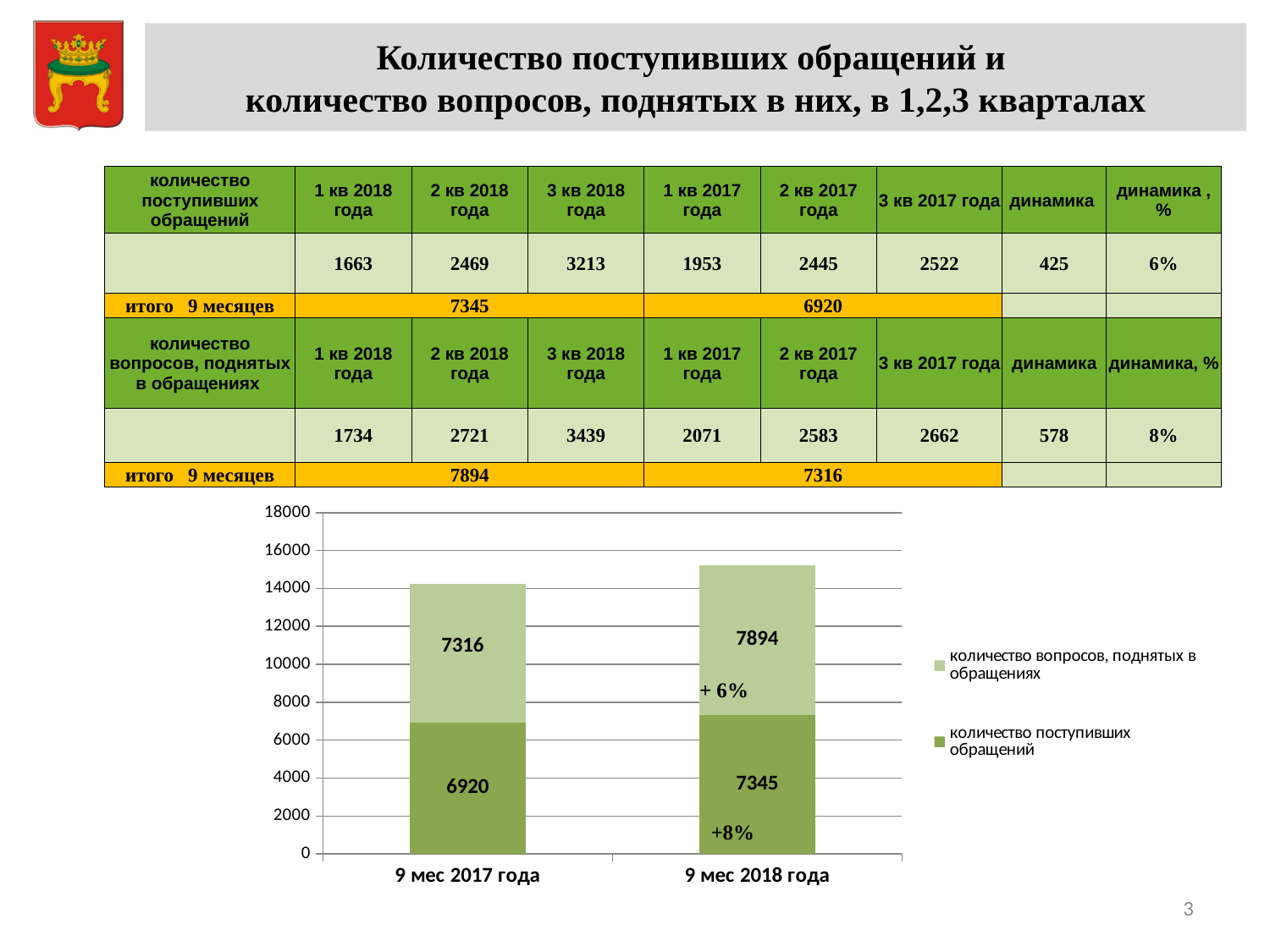
Which colour represents "количество поступивших обращений" in the chart? dark green How many series does the chart legend list? 2 What is the value of "количество поступивших обращений" for "9 мес 2018 года"? 7345 How many categories are shown on the x axis of the chart? 2 What kind of chart is shown on the slide? stacked bar chart Which is larger: "количество вопросов, поднятых в обращениях" for "9 мес 2018 года" or for "9 мес 2017 года"? 9 мес 2018 года What is the total of the stacked bar for "9 мес 2017 года"? 14236 What is the value of "количество вопросов, поднятых в обращениях" for "9 мес 2017 года"? 7316 What is the value of "количество вопросов, поднятых в обращениях" for "9 мес 2018 года"? 7894 What is the total of the stacked bar for "9 мес 2018 года"? 15239 What is the value of "количество поступивших обращений" for "9 мес 2017 года"? 6920 What is the difference between "количество поступивших обращений" for "9 мес 2018 года" and for "9 мес 2017 года"? 425